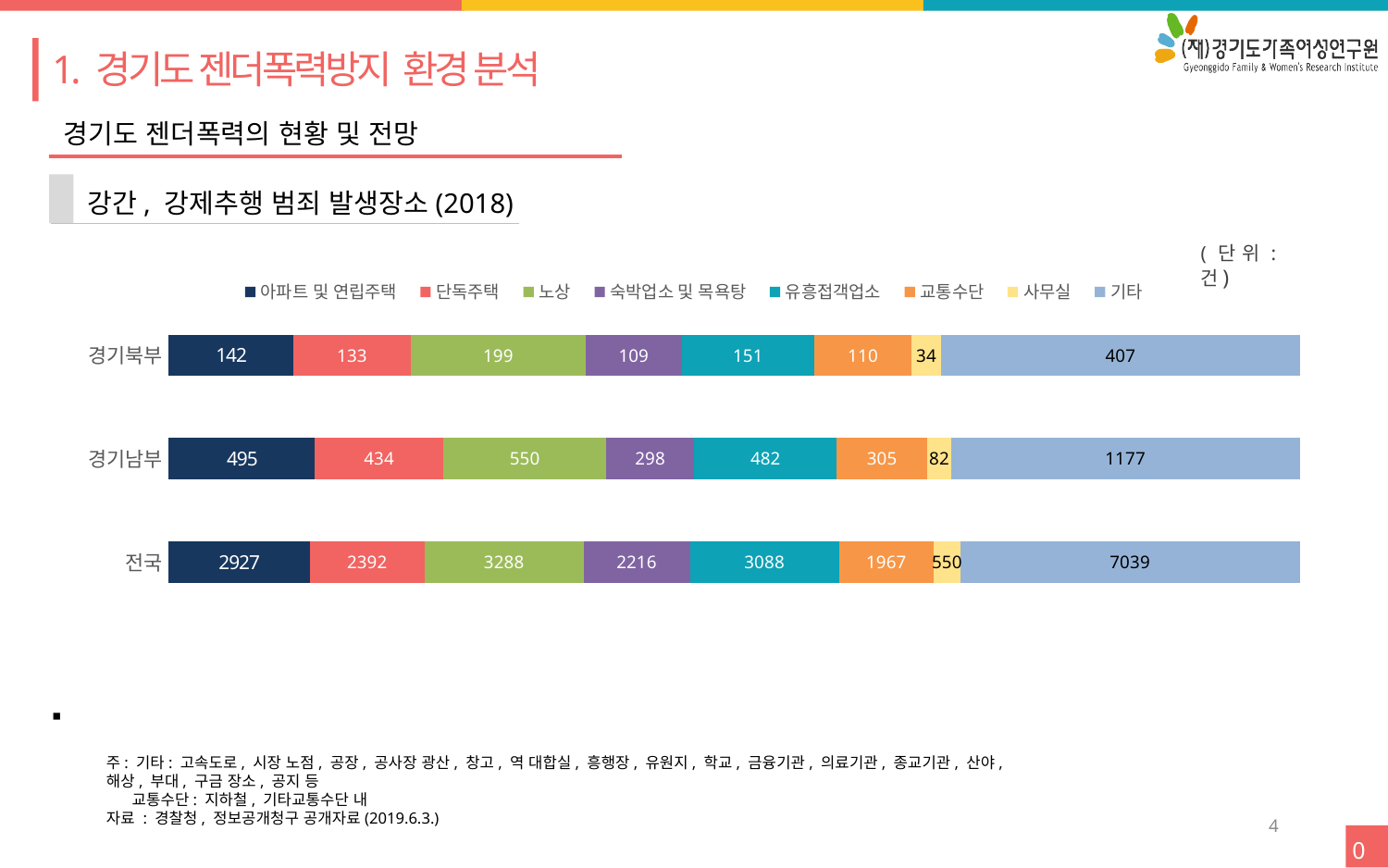
How many series does the legend list? 8 What is the value for 기타 in the 경기남부 bar? 1177 What kind of chart is shown on the slide? stacked bar chart How many categories (bars) are plotted in the chart? 3 What is the value for 사무실 in the 경기북부 bar? 34 What is the difference between 아파트 및 연립주택 and 단독주택 in the 경기남부 bar? 61 What is the value for 유흥접객업소 in the 전국 bar? 3088 Which is larger in the 경기북부 bar: 유흥접객업소 or 숙박업소 및 목욕탕? 유흥접객업소 Which series has the highest value in the 전국 bar? 기타 What is the total of the 경기북부 bar? 1285 What is the value for 노상 in the 경기북부 bar? 199 Which series has the lowest value in the 경기남부 bar? 사무실